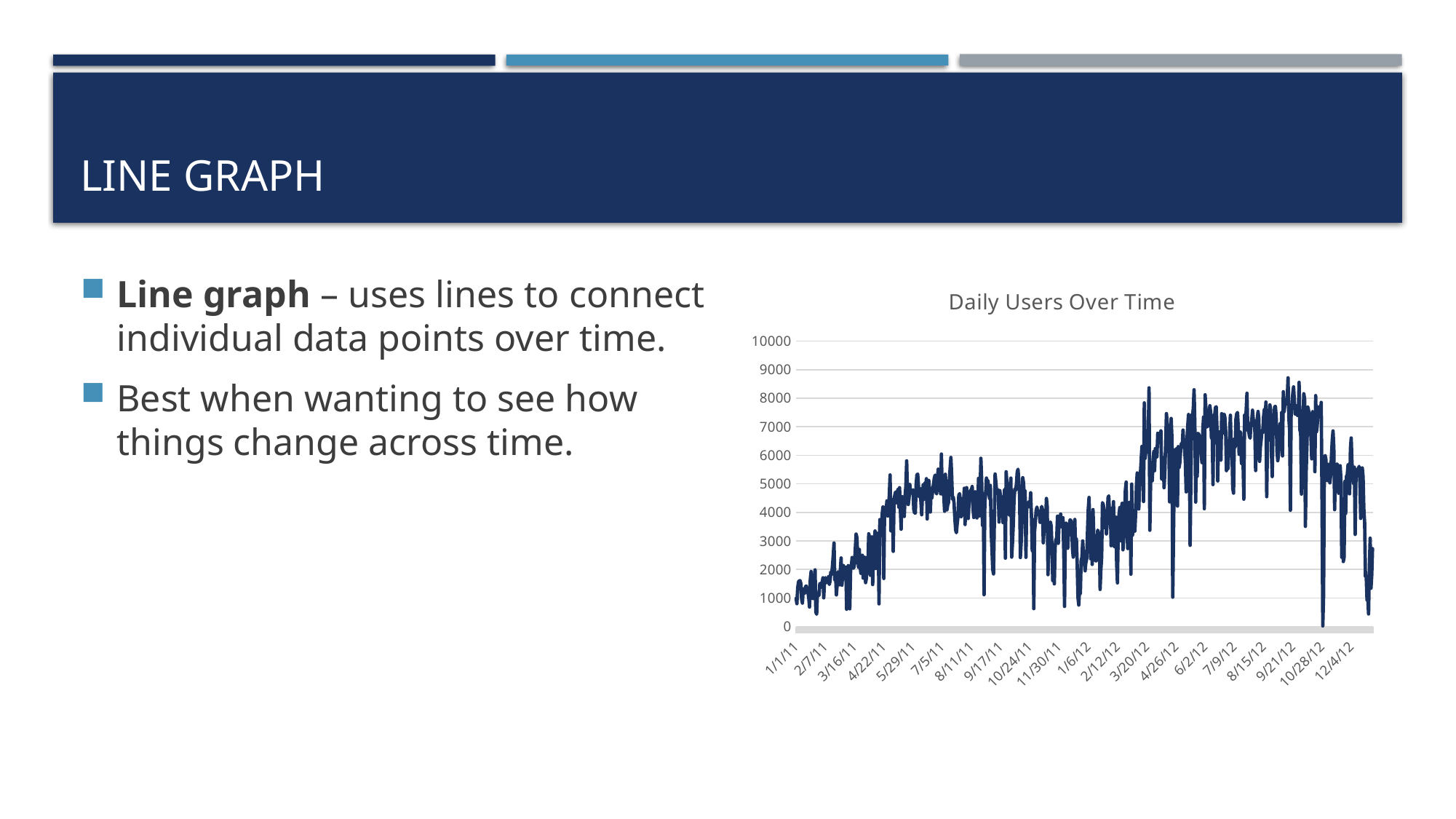
Is the value at the start of the chart (1/1/11) greater or less than 2000? less Do the values generally rise or fall between 1/1/11 and 5/29/11? rise What is the highest value shown on the y axis of the chart? 10000 Is the highest point on the line greater or less than 8000? greater Is the highest point on the line greater or less than 9000? less How many date labels are shown along the x axis of the chart? 20 What is the title of the chart on the slide? Daily Users Over Time Do the values generally rise or fall between 9/21/12 and 12/4/12? fall Which date label appears first on the x axis of the chart? 1/1/11 What kind of chart is shown on the slide? line chart